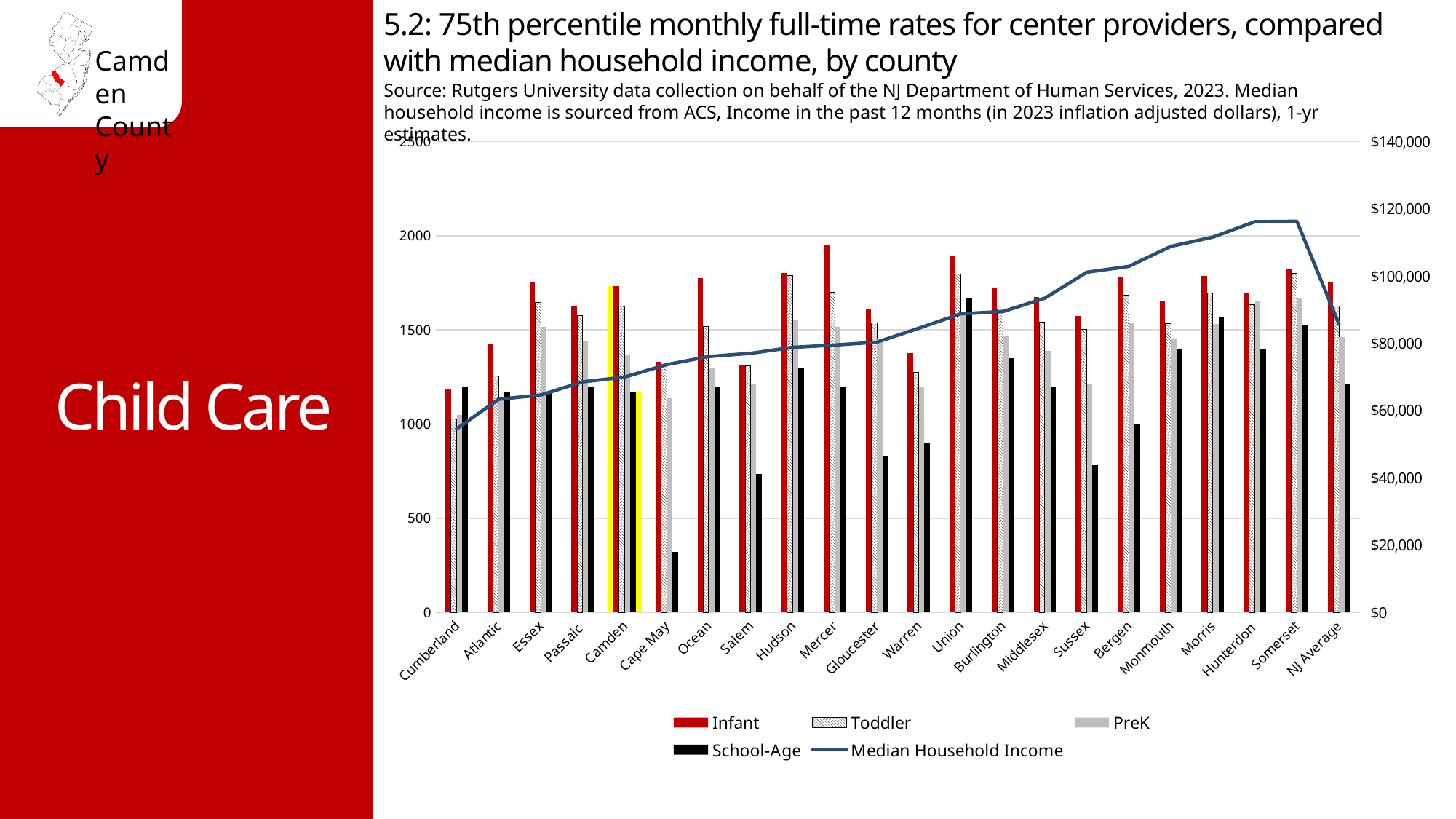
How many series does the legend list? 5 Which county has the lowest School-Age rate? Cape May Is the Infant value for Camden greater or less than 1500? greater How many counties/categories are shown along the x axis? 22 What kind of chart is shown on the slide? Bar chart with a line Is the School-Age value for Cape May greater or less than 500? less Which county's bars are highlighted in yellow? Camden Which county has the lowest Infant rate? Cumberland Does the Median Household Income line generally rise or fall from Cumberland to Somerset? rise Which county has the highest Infant rate? Mercer Which is larger, the School-Age value for Salem or for Cape May? Salem Is the Median Household Income for Somerset greater or less than $100,000? greater